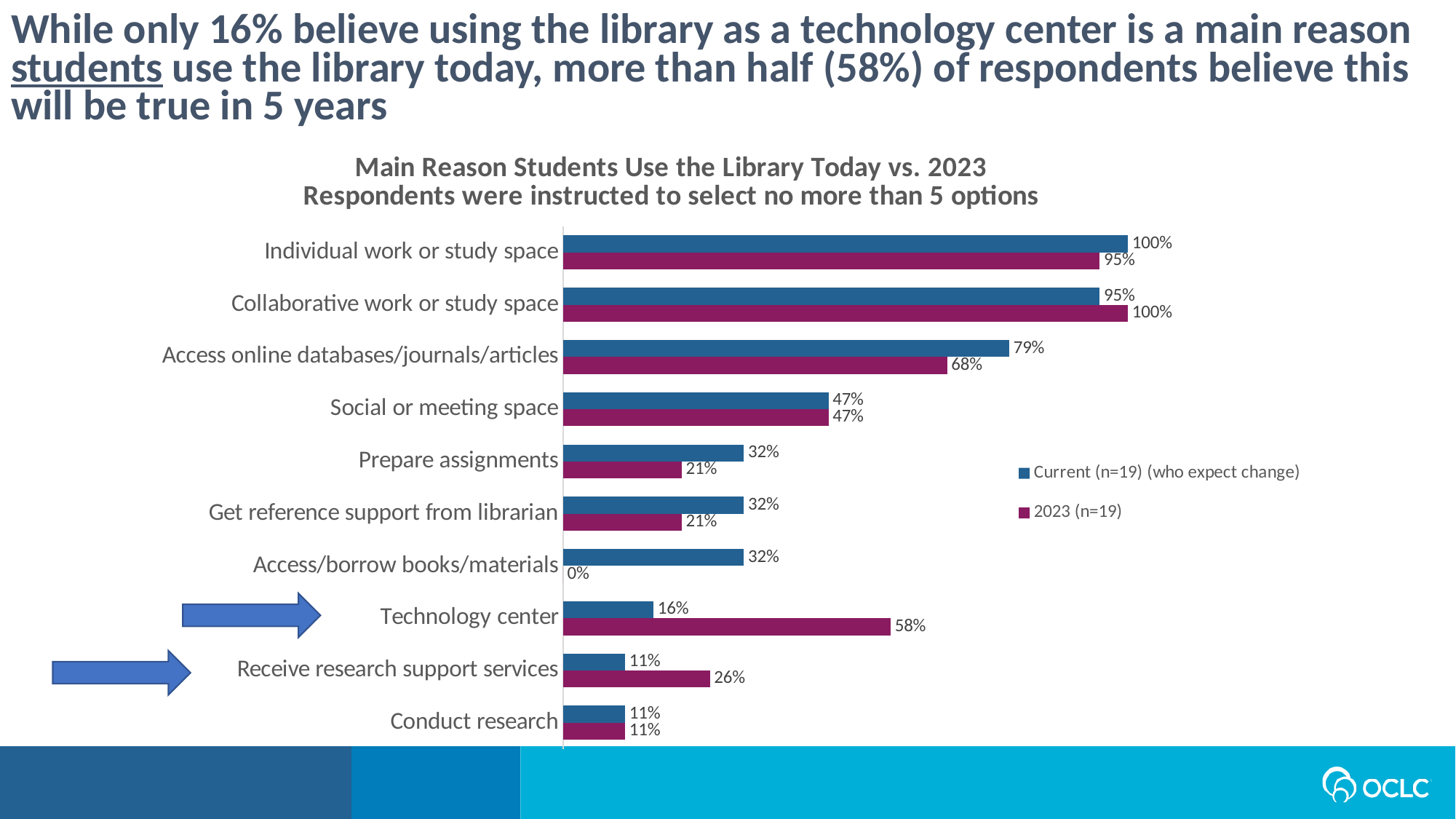
Which is larger for Receive research support services, the Current value or the 2023 value? 2023 What is the Current value for Access online databases/journals/articles? 79% How many categories are shown in the chart? 10 Which category has the highest Current value? Individual work or study space What is the 2023 value for Access/borrow books/materials? 0% What kind of chart is shown on the slide? Bar chart What is the 2023 value for Technology center? 58% Which category has the lowest 2023 value? Access/borrow books/materials What is the Current value for Technology center? 16% How many series does the legend list? 2 What is the difference between the 2023 and Current values for Technology center? 42% What is the title of the chart? Main Reason Students Use the Library Today vs. 2023